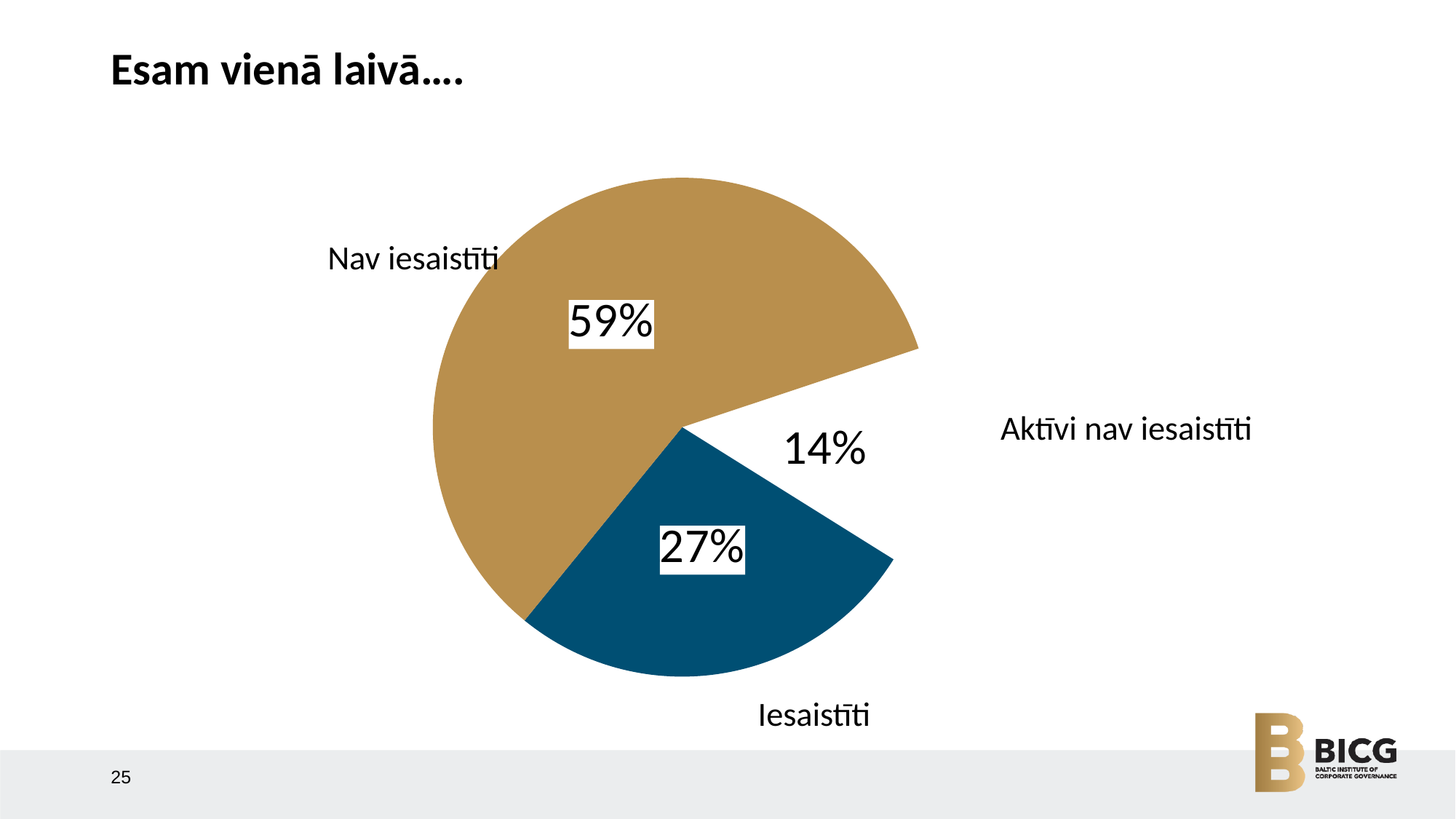
What kind of chart is shown on the slide? pie chart What share of the pie is labelled "Nav iesaistīti"? 59% How many slices does the pie chart have? 3 Which is larger, the share for "Iesaistīti" or the share for "Aktīvi nav iesaistīti"? Iesaistīti What share of the pie is labelled "Iesaistīti"? 27% What share of the pie is labelled "Aktīvi nav iesaistīti"? 14% Which category has the largest share of the pie? Nav iesaistīti Which category has the smallest share of the pie? Aktīvi nav iesaistīti What is the difference in percentage points between "Nav iesaistīti" and "Iesaistīti"? 32 What is the title of the slide containing the pie chart? Esam vienā laivā…. What colour is the "Iesaistīti" slice? dark blue What is the difference in percentage points between "Iesaistīti" and "Aktīvi nav iesaistīti"? 13